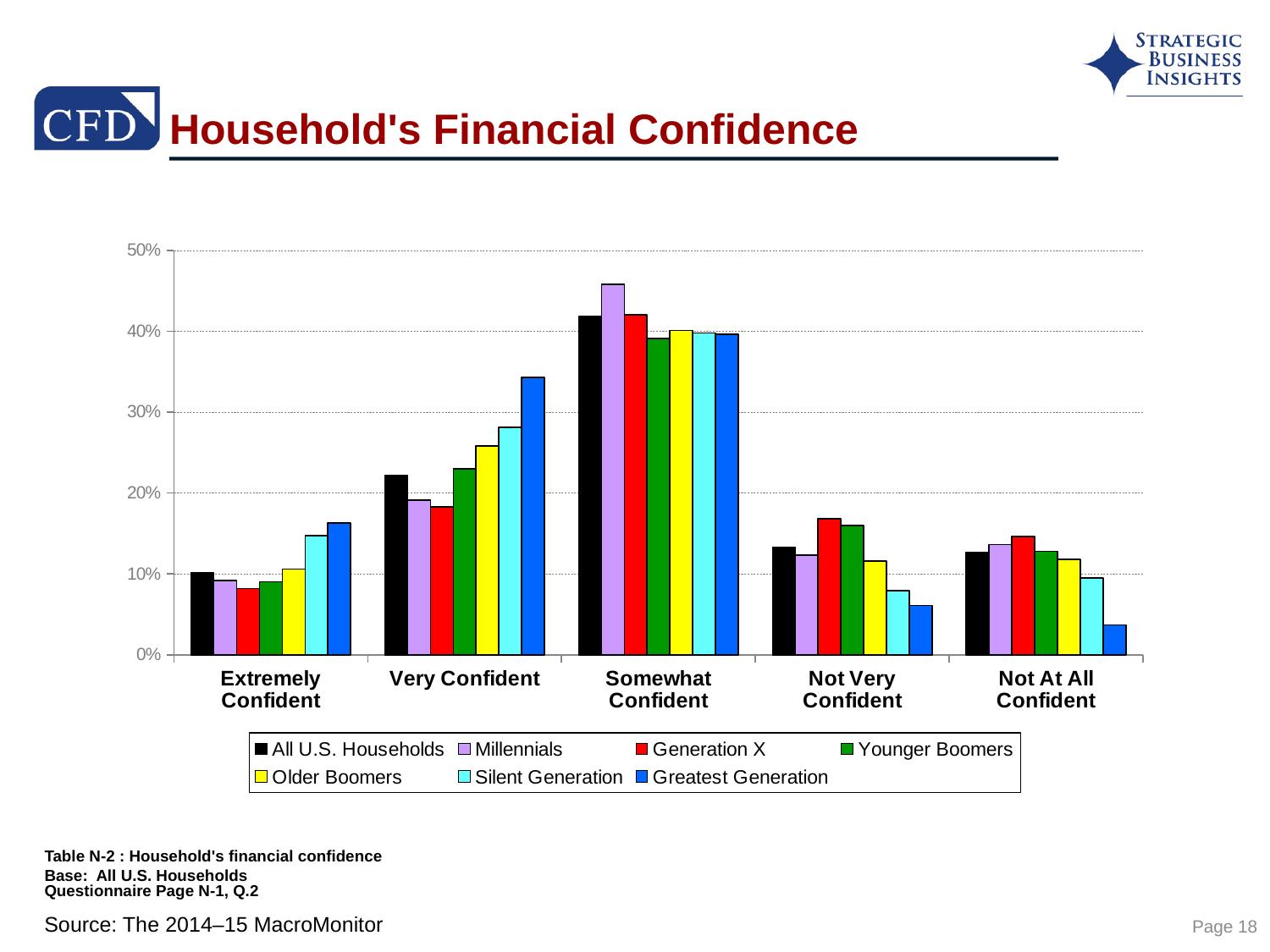
Is the value for Greatest Generation in the Very Confident category greater or less than 30%? greater Is the value for Greatest Generation in the Not Very Confident category greater or less than 10%? less Which series has the lowest value in the Not Very Confident category? Greatest Generation How many series does the legend list? 7 Which series has the highest value in the Very Confident category? Greatest Generation In the Not Very Confident category, which is larger: Generation X or Silent Generation? Generation X What is the title of the chart on the slide? Household's Financial Confidence Is the value for Millennials in the Somewhat Confident category greater or less than 40%? greater What kind of chart is shown on the slide? Bar chart Which series has the lowest value in the Not At All Confident category? Greatest Generation Which series has the highest value in the Somewhat Confident category? Millennials How many confidence categories are shown along the x axis? 5